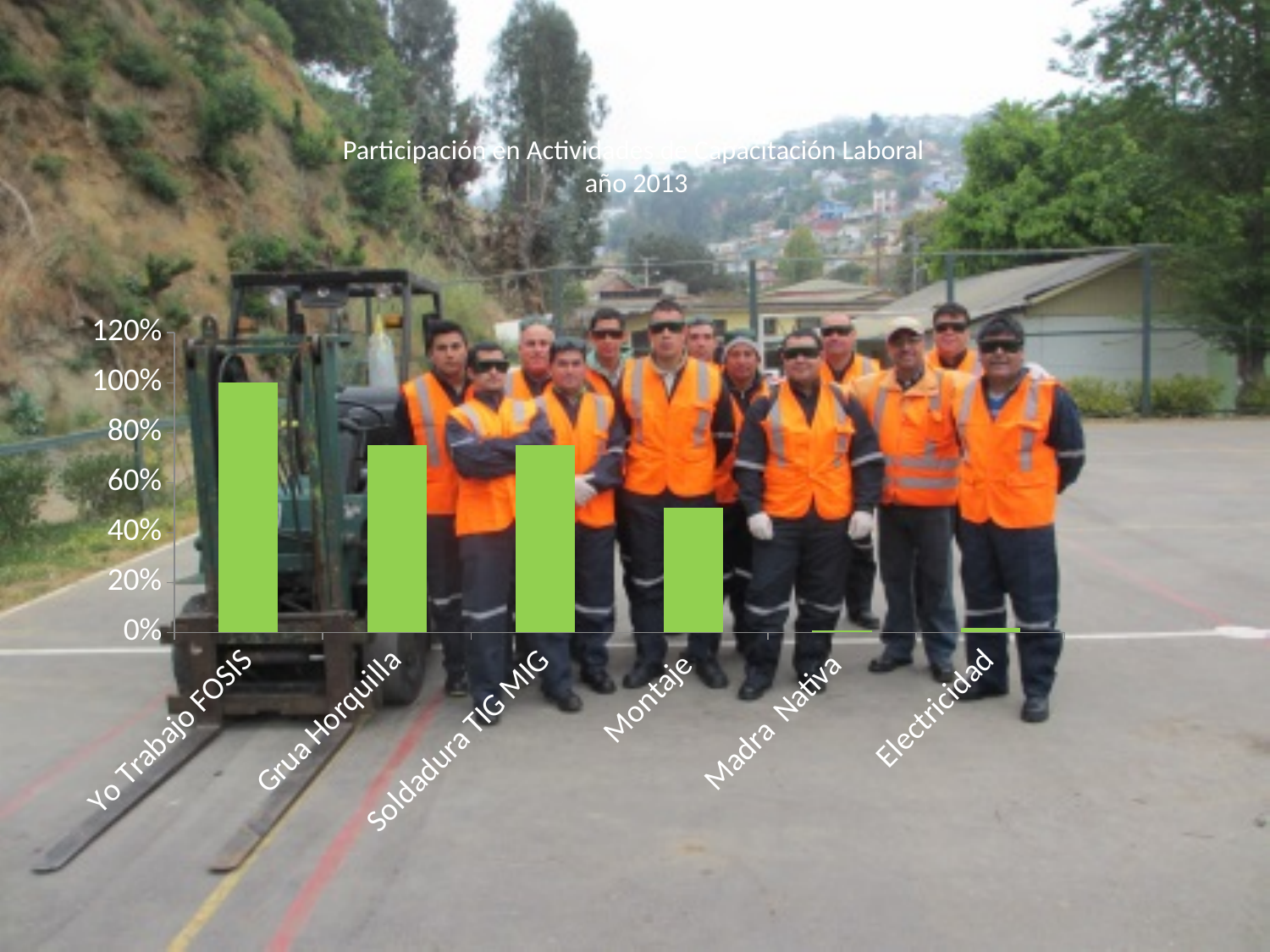
Is the value for Madra Nativa greater or less than 20%? less Do the values generally rise or fall from left to right along the x axis? fall Which is larger, the value for Yo Trabajo FOSIS or the value for Montaje? Yo Trabajo FOSIS How many categories are shown on the x axis of the chart? 6 What is the title of the chart? Participación en Actividades de Capacitación Laboral año 2013 What is the value for Yo Trabajo FOSIS? 100% What kind of chart is shown on the slide? bar chart Is the value for Montaje greater or less than 40%? greater Is the value for Grua Horquilla greater or less than 60%? greater Which is larger, the value for Grua Horquilla or the value for Electricidad? Grua Horquilla Which category has the highest value in the chart? Yo Trabajo FOSIS